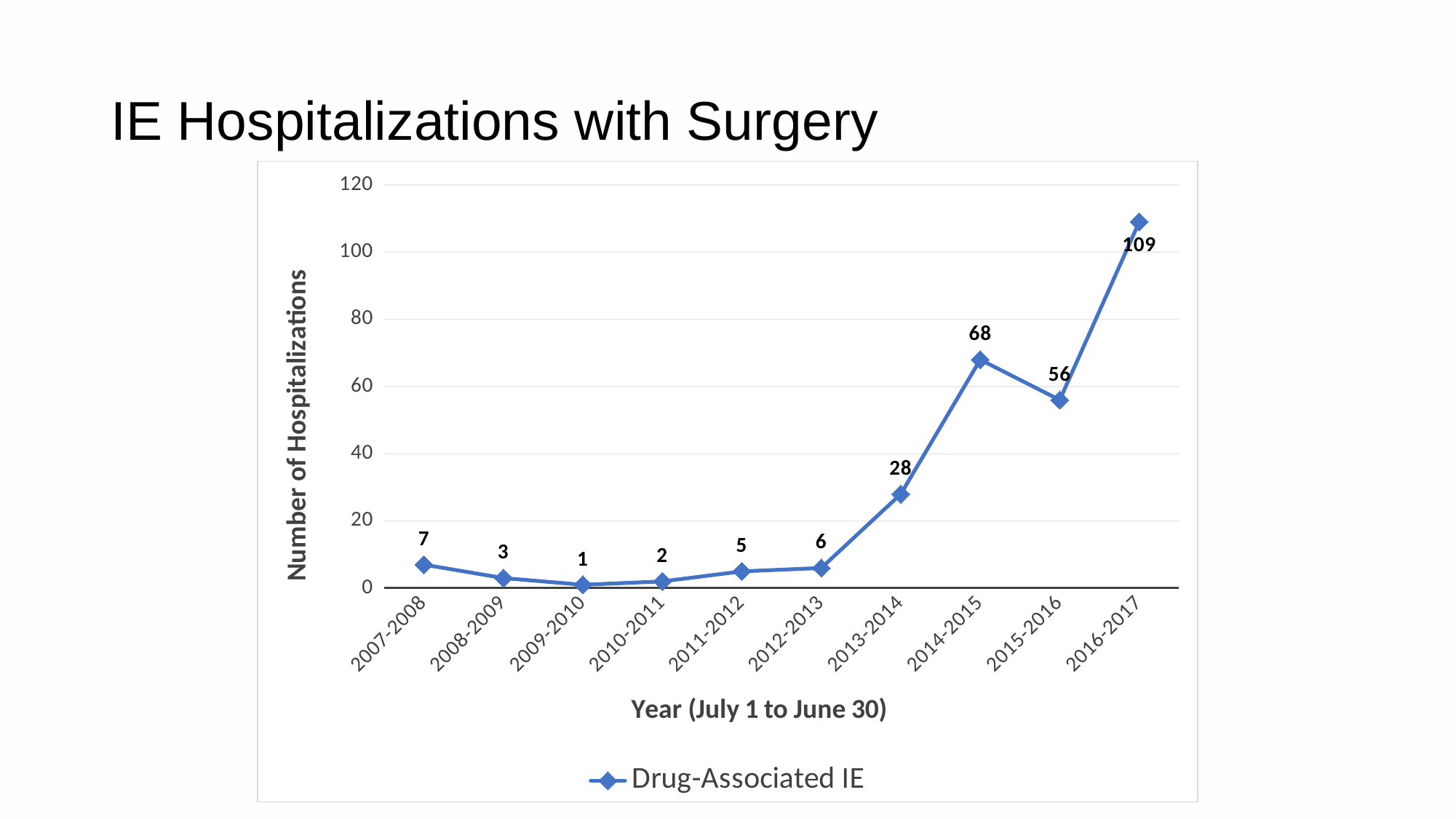
Which year has the lowest number of hospitalizations? 2009-2010 What is the number of hospitalizations for 2016-2017? 109 Which year has more hospitalizations, 2007-2008 or 2012-2013? 2007-2008 What kind of chart is shown on the slide? Line chart How many series does the legend list? 1 What is the number of hospitalizations for 2013-2014? 28 What is the number of hospitalizations for 2009-2010? 1 Is the value for 2014-2015 greater or less than 60? greater What is the name of the series shown in the legend? Drug-Associated IE Which year has the highest number of hospitalizations? 2016-2017 What is the difference in hospitalizations between 2014-2015 and 2015-2016? 12 How many years are plotted on the x axis? 10